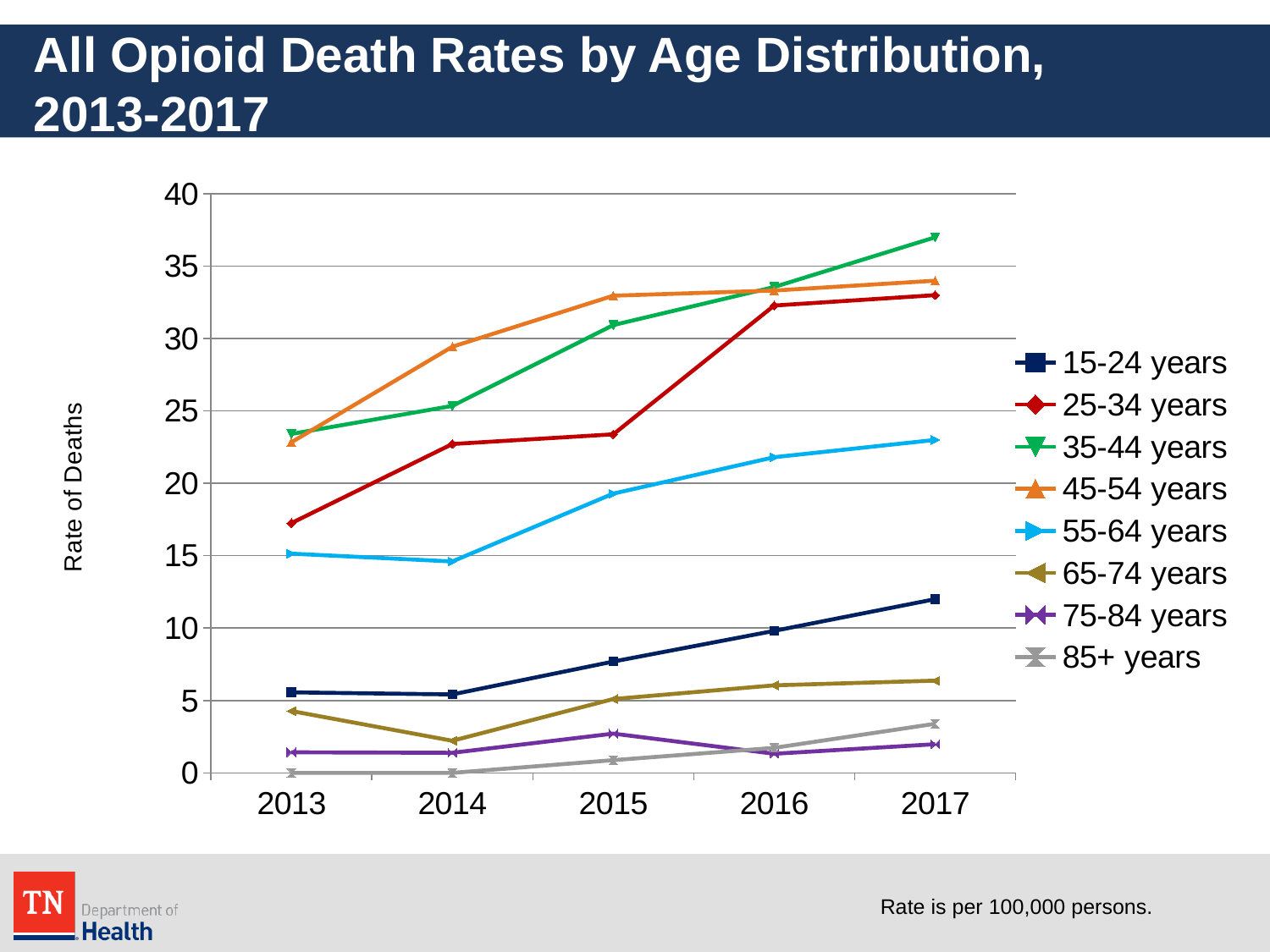
What kind of chart is shown on the slide? line chart In 2013, which has the larger rate of deaths: 25-34 years or 55-64 years? 25-34 years Is the value for 35-44 years in 2017 greater or less than 35? greater Which age group has the highest rate of deaths in 2017? 35-44 years How many years are shown along the x axis? 5 How many age groups does the legend list? 8 Does the rate of deaths for 15-24 years rise or fall from 2014 to 2017? rise Is the value for 55-64 years in 2017 greater or less than 20? greater Is the value for 15-24 years in 2017 greater or less than 10? greater Which age group has the lowest rate of deaths in 2013? 85+ years Which age group has the highest rate of deaths in 2015? 45-54 years What is the label on the y axis? Rate of Deaths